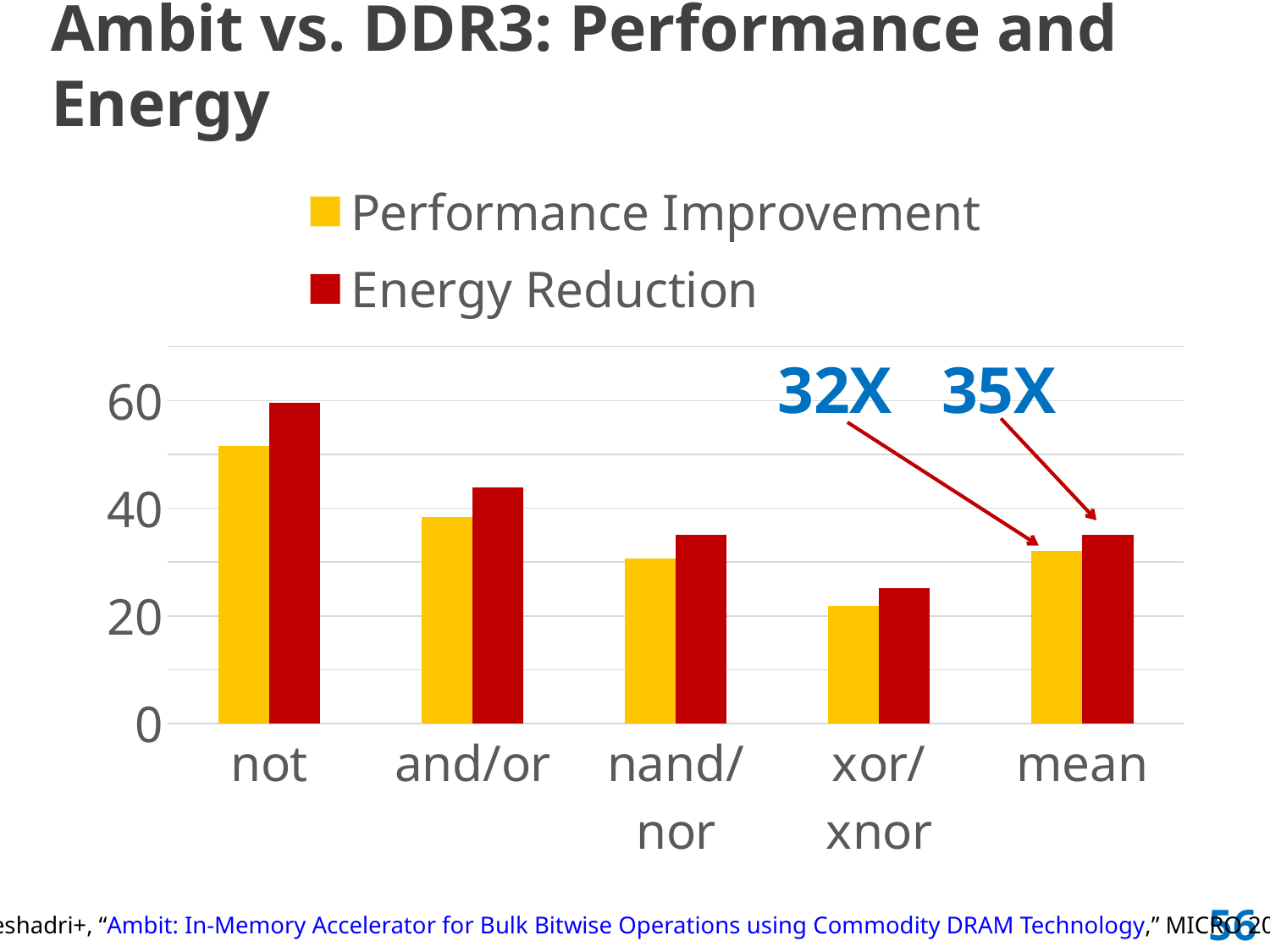
Which operation has the highest Performance Improvement? not What is the mean Energy Reduction labelled on the chart? 35X Do the Performance Improvement values rise or fall from not to xor/xnor along the x axis? fall For the not operation, which is larger: Performance Improvement or Energy Reduction? Energy Reduction Is the Performance Improvement for not greater or less than 40? greater How many categories are shown on the x axis? 5 What is the difference between the labelled mean Energy Reduction and the labelled mean Performance Improvement? 3X Is the Energy Reduction for xor/xnor greater or less than 40? less How many series does the legend list? 2 Which operation has the lowest Energy Reduction? xor/xnor What is the mean Performance Improvement labelled on the chart? 32X What kind of chart is shown on the slide? bar chart